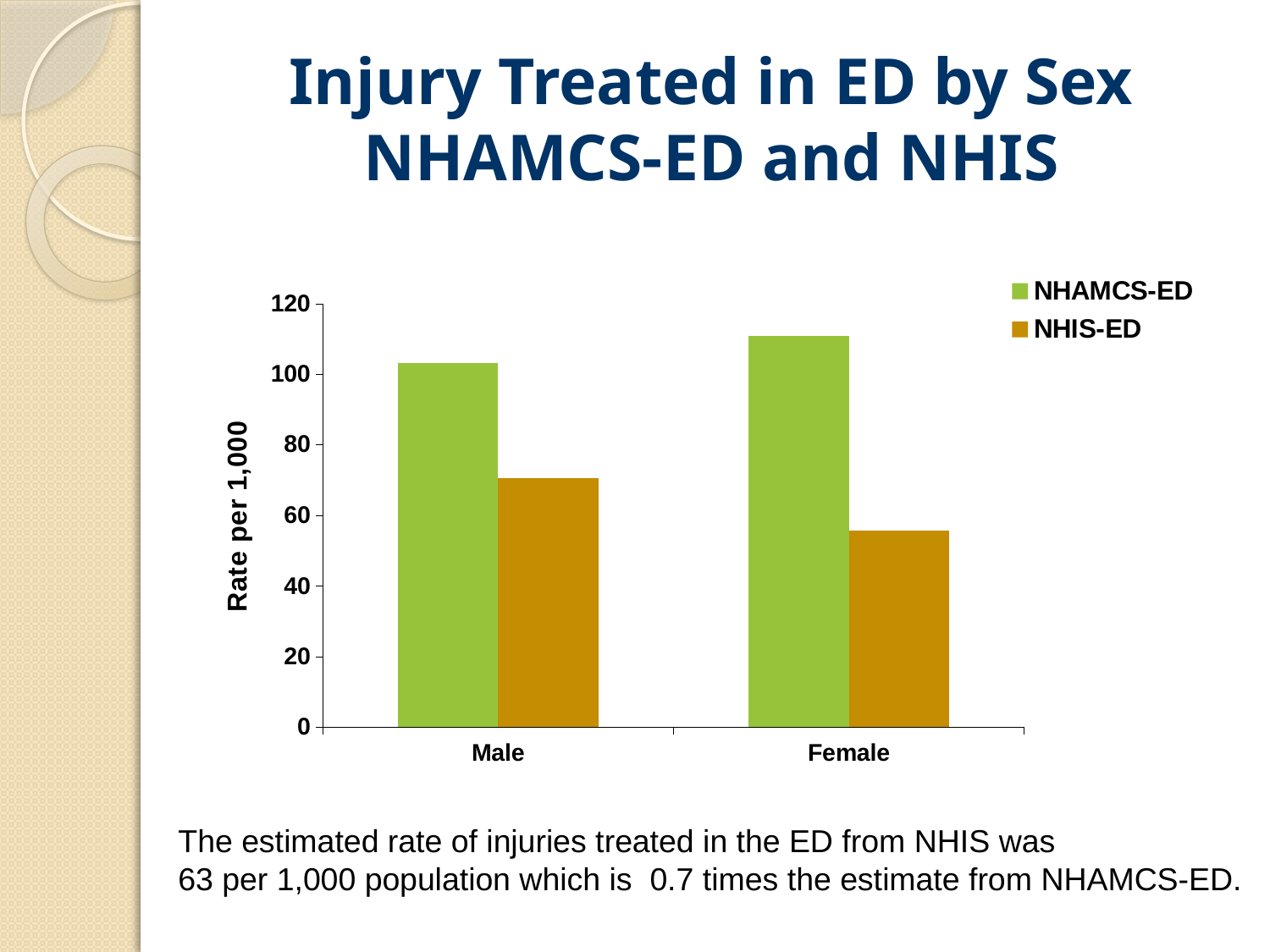
What is the label of the y axis? Rate per 1,000 Which series has the lowest bar on the chart? NHIS-ED Is the NHIS-ED value for Male greater or less than 80? less What kind of chart is shown on the slide? bar chart Is the NHAMCS-ED value for Female greater or less than 100? greater How many categories are shown on the x axis? 2 How many series does the legend list? 2 Which category has the higher NHAMCS-ED value, Male or Female? Female Is the NHIS-ED value for Female greater or less than 60? less Which category has the higher NHIS-ED value, Male or Female? Male Which series is shown in green in the legend? NHAMCS-ED